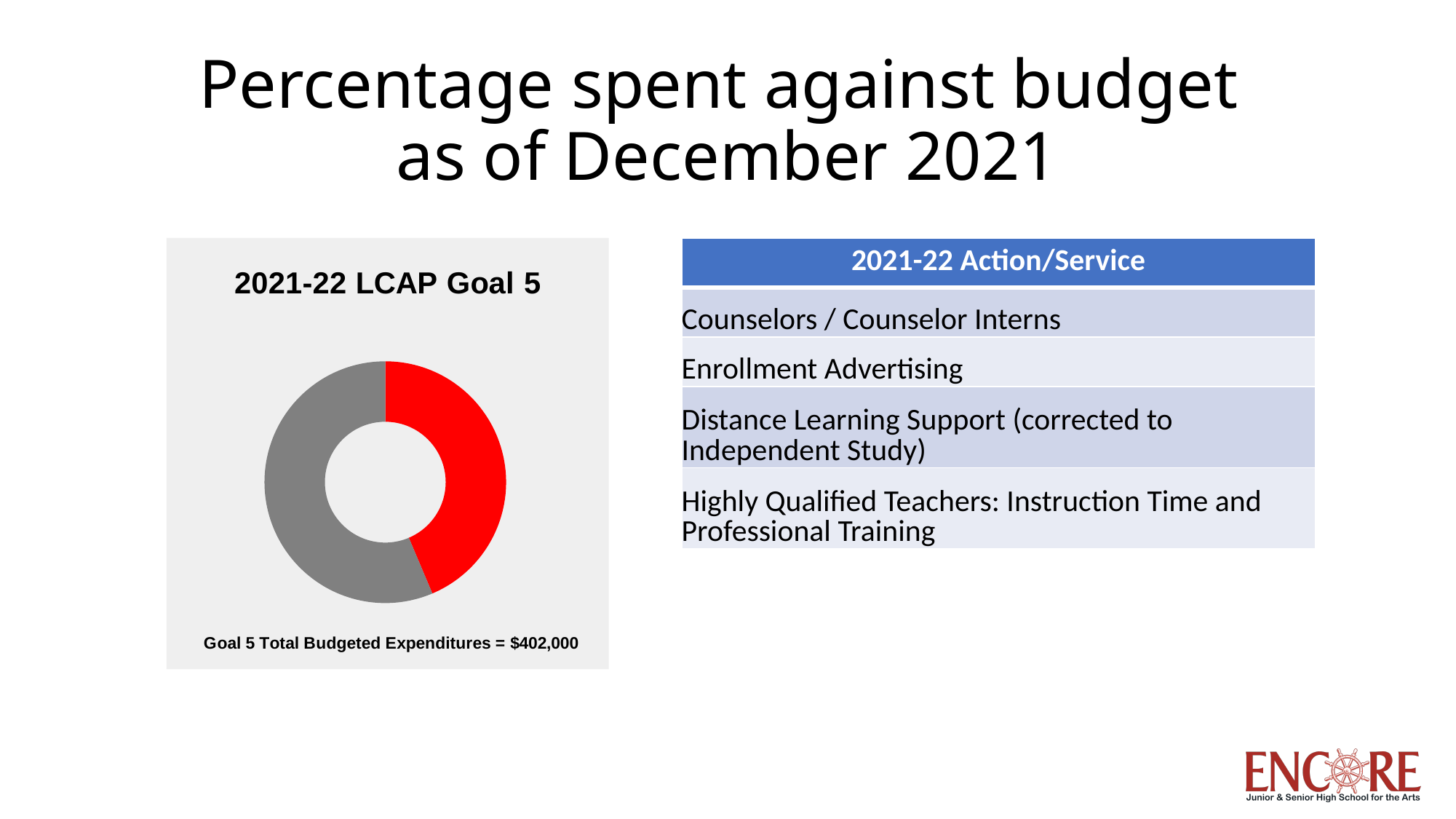
Does the red slice of the doughnut chart take up more or less than half of the ring? less How many slices does the doughnut chart have? 2 Which slice of the doughnut chart is the smallest? The red slice What kind of chart is shown on the slide? Doughnut chart Which slice of the doughnut chart is the largest? The gray slice What total budgeted expenditure figure is printed below the doughnut chart? $402,000 Does the gray slice of the doughnut chart take up more or less than half of the ring? more What is the title of the chart on the slide? 2021-22 LCAP Goal 5 What two colours are used for the slices of the doughnut chart? Red and gray Which slice of the doughnut chart is larger, the red one or the gray one? The gray one